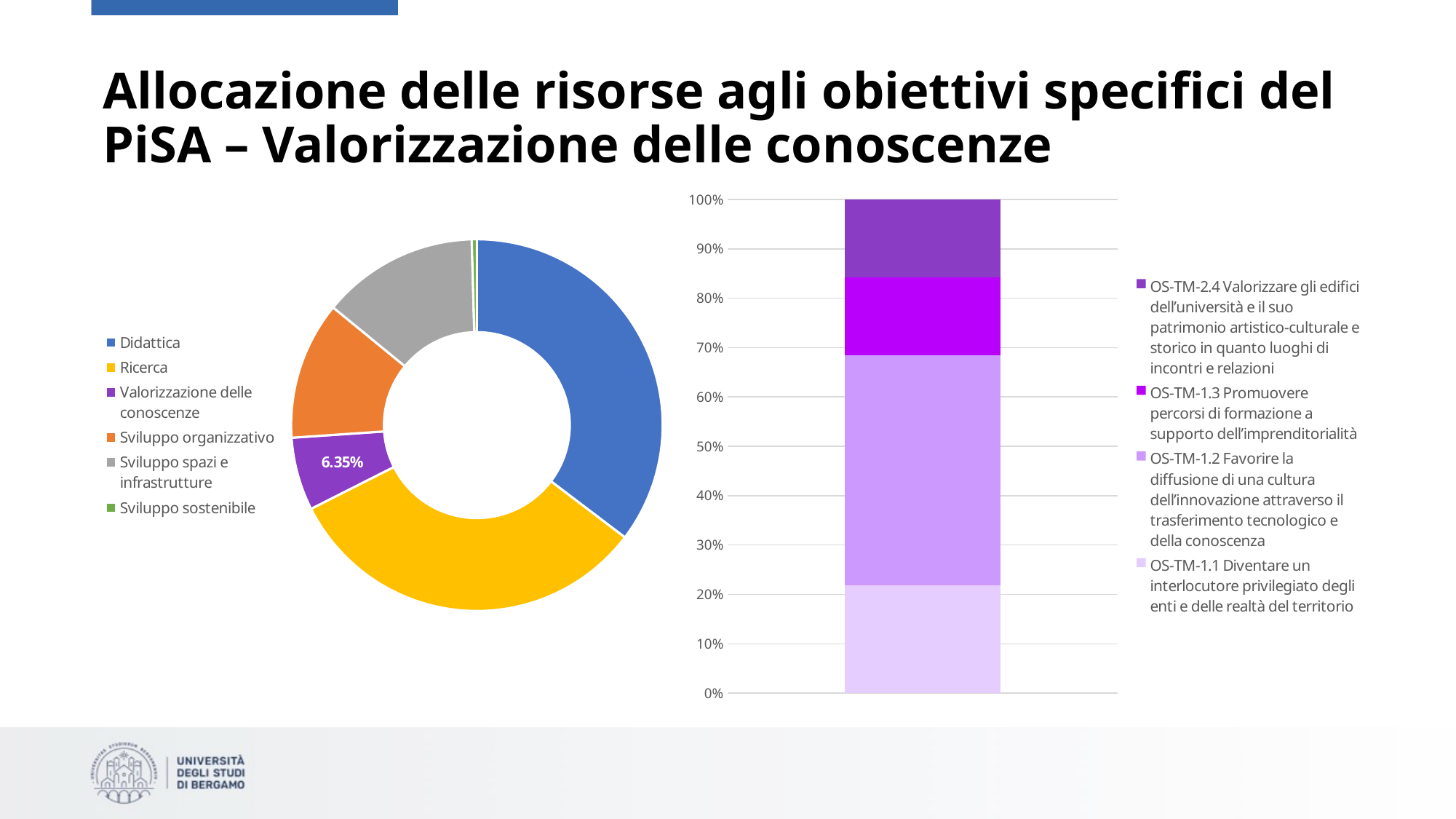
What kind of chart is the chart on the left of the slide? Donut (pie) chart In the donut chart on the left, what share is shown for Valorizzazione delle conoscenze? 6.35% In the donut chart on the left, which slice is larger: Didattica or Sviluppo spazi e infrastrutture? Didattica In the donut chart on the left, which category has the smallest slice? Sviluppo sostenibile In the stacked bar chart on the right, which series has the largest segment? OS-TM-1.2 Favorire la diffusione di una cultura dell'innovazione attraverso il trasferimento tecnologico e della conoscenza What kind of chart is the chart on the right of the slide? Stacked bar chart In the stacked bar chart on the right, is the share for OS-TM-1.1 greater or less than 30%? less In the stacked bar chart on the right, is the share for OS-TM-1.2 greater or less than 40%? greater How many series does the legend of the stacked bar chart on the right list? 4 How many categories does the legend of the donut chart on the left list? 6 In the stacked bar chart on the right, which series is at the top of the bar? OS-TM-2.4 Valorizzare gli edifici dell'università e il suo patrimonio artistico-culturale e storico in quanto luoghi di incontri e relazioni In the donut chart on the left, which slice is larger: Sviluppo organizzativo or Valorizzazione delle conoscenze? Sviluppo organizzativo